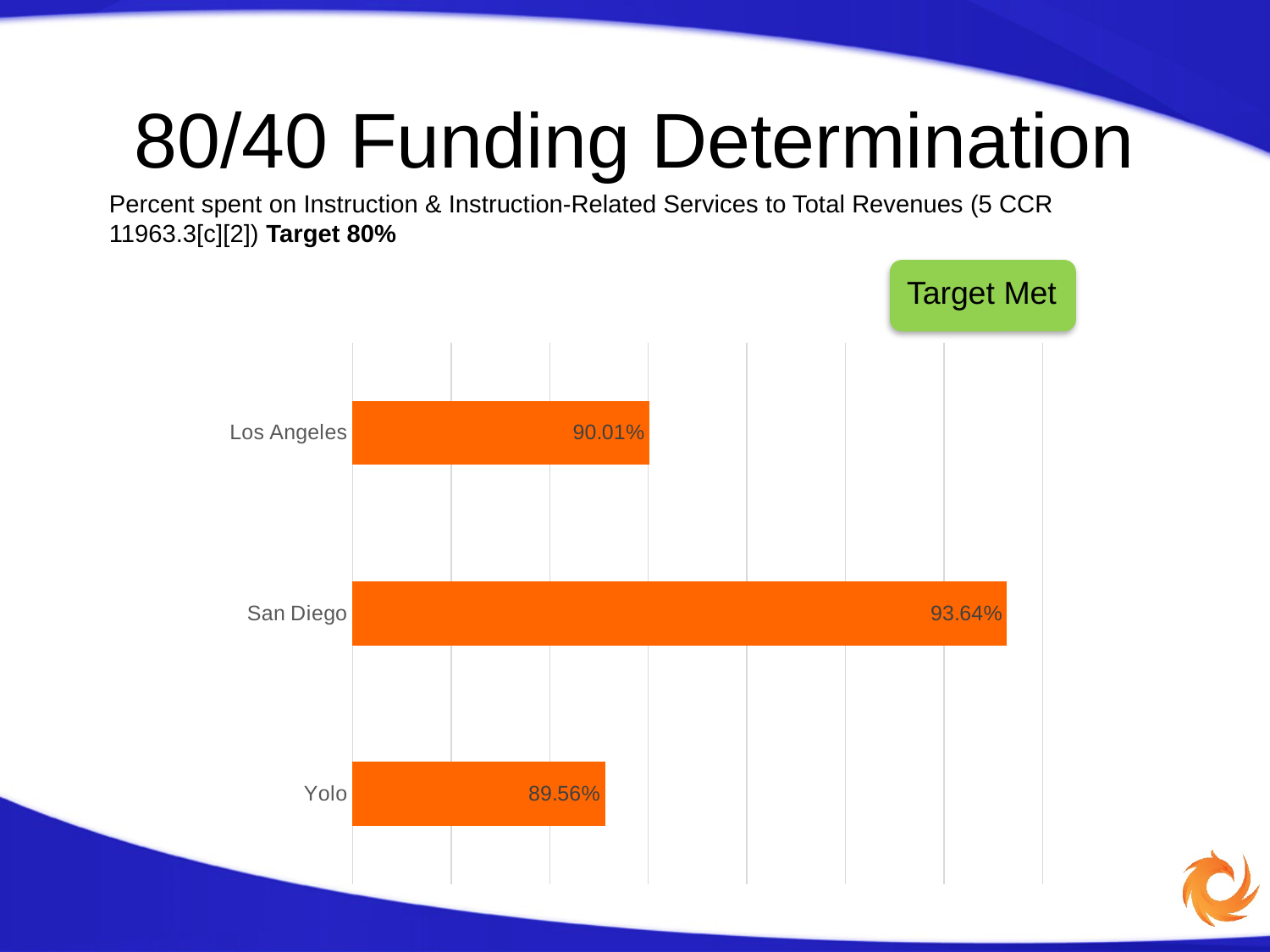
What is the value for Yolo? 89.56% What is the difference between the values for Los Angeles and Yolo? 0.45% Which category has the lowest value? Yolo Which category has the highest value? San Diego How many categories are shown in the chart? 3 What is the target percentage stated on the slide? 80% What kind of chart is shown on the slide? Bar chart What is the value for Los Angeles? 90.01% What is the difference between the values for San Diego and Los Angeles? 3.63% What is the value for San Diego? 93.64% What colour are the bars in the chart? Orange Which is larger, the value for San Diego or the value for Yolo? San Diego